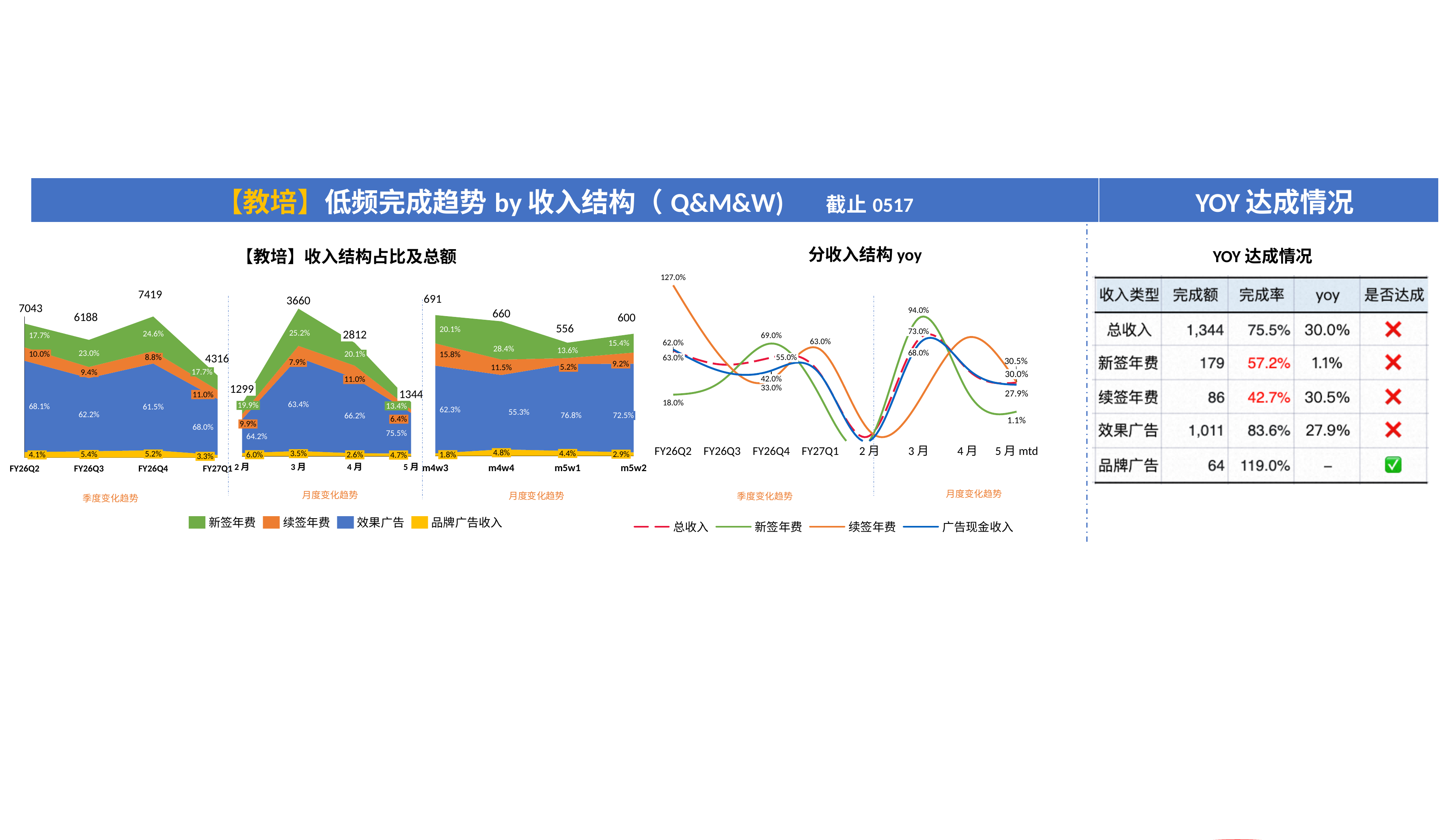
In the right chart 分收入结构 yoy, what is the 续签年费 yoy value at FY26Q2? 127.0% In the right chart 分收入结构 yoy, what is the 新签年费 yoy value at 5月 mtd? 1.1% In the left chart 【教培】收入结构占比及总额, which weekly total is larger, m5w1 or m5w2? m5w2 In the right chart 分收入结构 yoy, how many series does the legend list? 4 What kind of chart is the left chart 【教培】收入结构占比及总额? Stacked area chart In the left chart 【教培】收入结构占比及总额, what is the total for FY26Q4? 7419 In the left chart 【教培】收入结构占比及总额, which month among 2月 to 5月 has the lowest total? 2月 In the left chart 【教培】收入结构占比及总额, what is the 效果广告 share in FY26Q2? 68.1% In the left chart 【教培】收入结构占比及总额, how many series does the legend list? 4 In the left chart 【教培】收入结构占比及总额, what is the 新签年费 share in 3月? 25.2% In the left chart 【教培】收入结构占比及总额, what is the difference between the FY26Q2 total and the FY26Q3 total? 855 In the left chart 【教培】收入结构占比及总额, which quarter among FY26Q2 to FY27Q1 has the highest total? FY26Q4